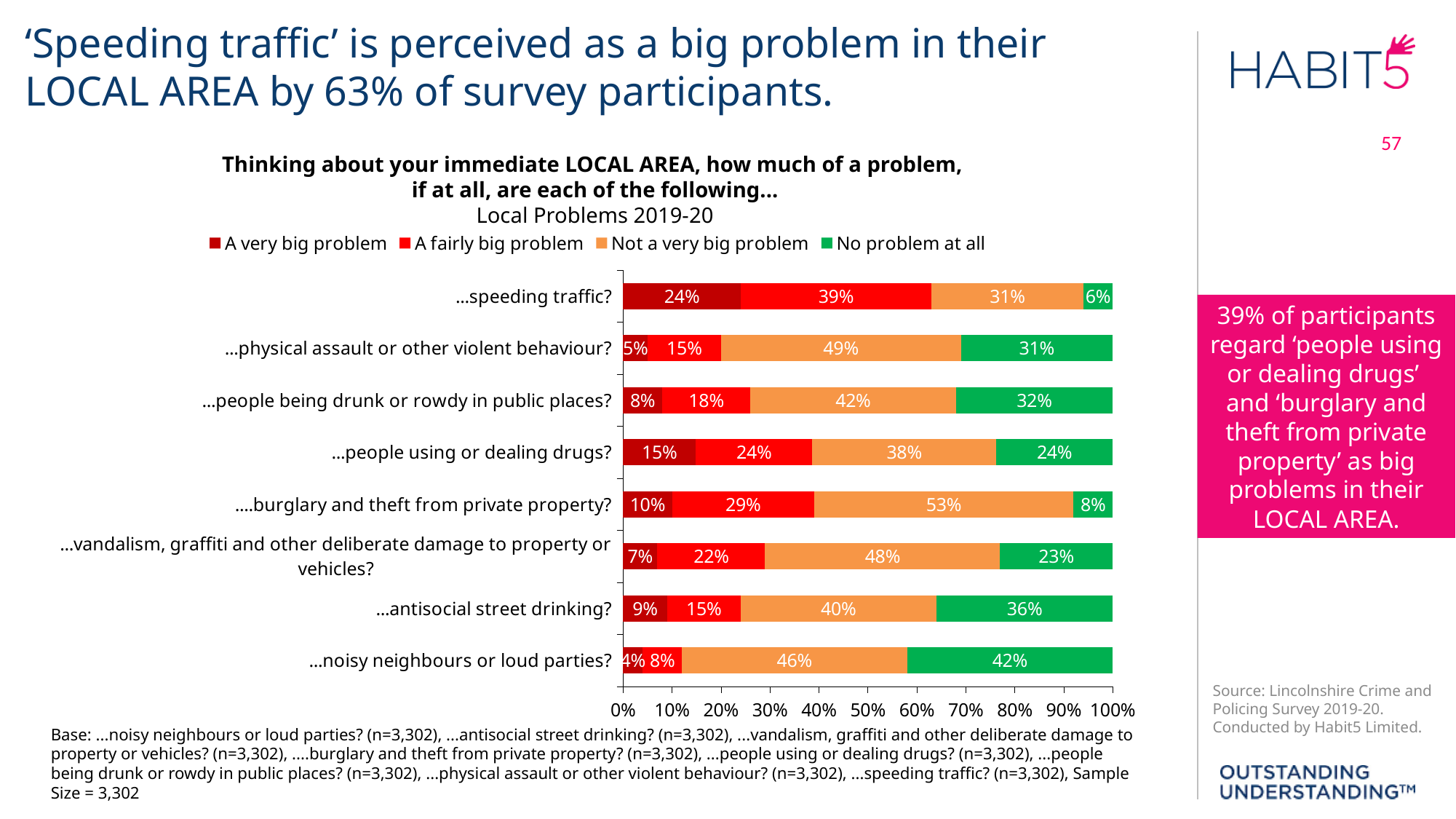
What is the difference between the 'A fairly big problem' percentages for speeding traffic and for noisy neighbours or loud parties? 31% Which local problem has the highest 'A very big problem' percentage? ...speeding traffic? What kind of chart is shown on the slide? Stacked bar chart What percentage of participants said speeding traffic is 'A very big problem' in their local area? 24% How many local problems (categories) are shown in the chart? 8 What is the combined percentage of 'A very big problem' and 'A fairly big problem' for speeding traffic? 63% How many series does the legend list? 4 Which local problem has the lowest 'No problem at all' percentage? ...speeding traffic? What percentage of participants said noisy neighbours or loud parties are 'No problem at all'? 42% Which legend entry is shown in green? No problem at all What percentage of participants said burglary and theft from private property is 'Not a very big problem'? 53% Which has a larger 'No problem at all' percentage: antisocial street drinking or people using or dealing drugs? ...antisocial street drinking?